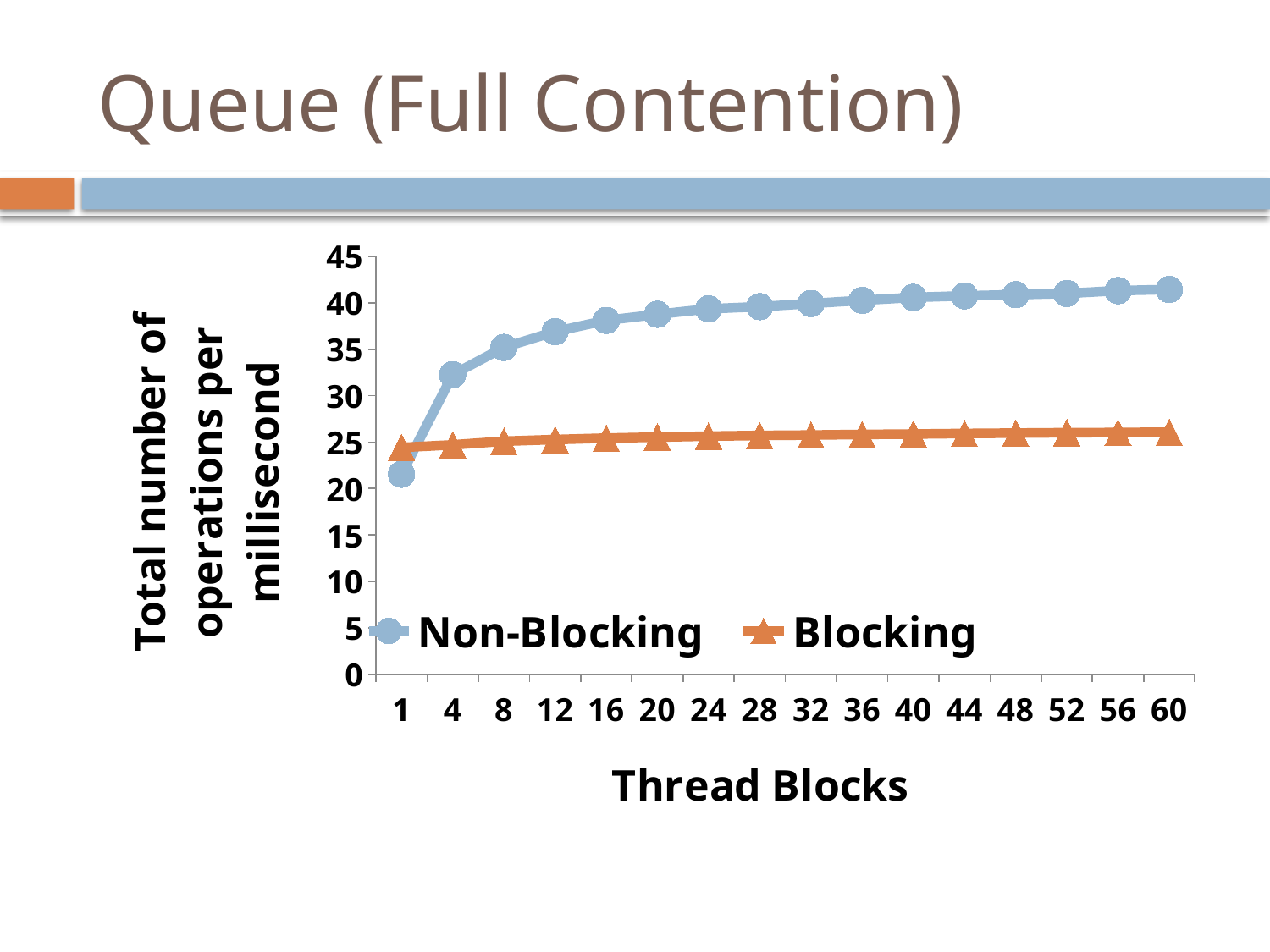
At which number of thread blocks is the Non-Blocking series lowest? 1 Is the Blocking value at 32 thread blocks greater or less than 30? less How many series does the legend list? 2 Is the Non-Blocking value at 4 thread blocks greater or less than 30? greater Does the Non-Blocking series rise or fall as the number of thread blocks increases? rise At 1 thread block, which series has the higher value, Non-Blocking or Blocking? Blocking What kind of chart is shown on the slide? line chart At 60 thread blocks, which series has the higher value, Non-Blocking or Blocking? Non-Blocking Is the Non-Blocking value at 60 thread blocks greater or less than 40? greater What is the title of the x axis? Thread Blocks How many thread block values are plotted along the x axis? 16